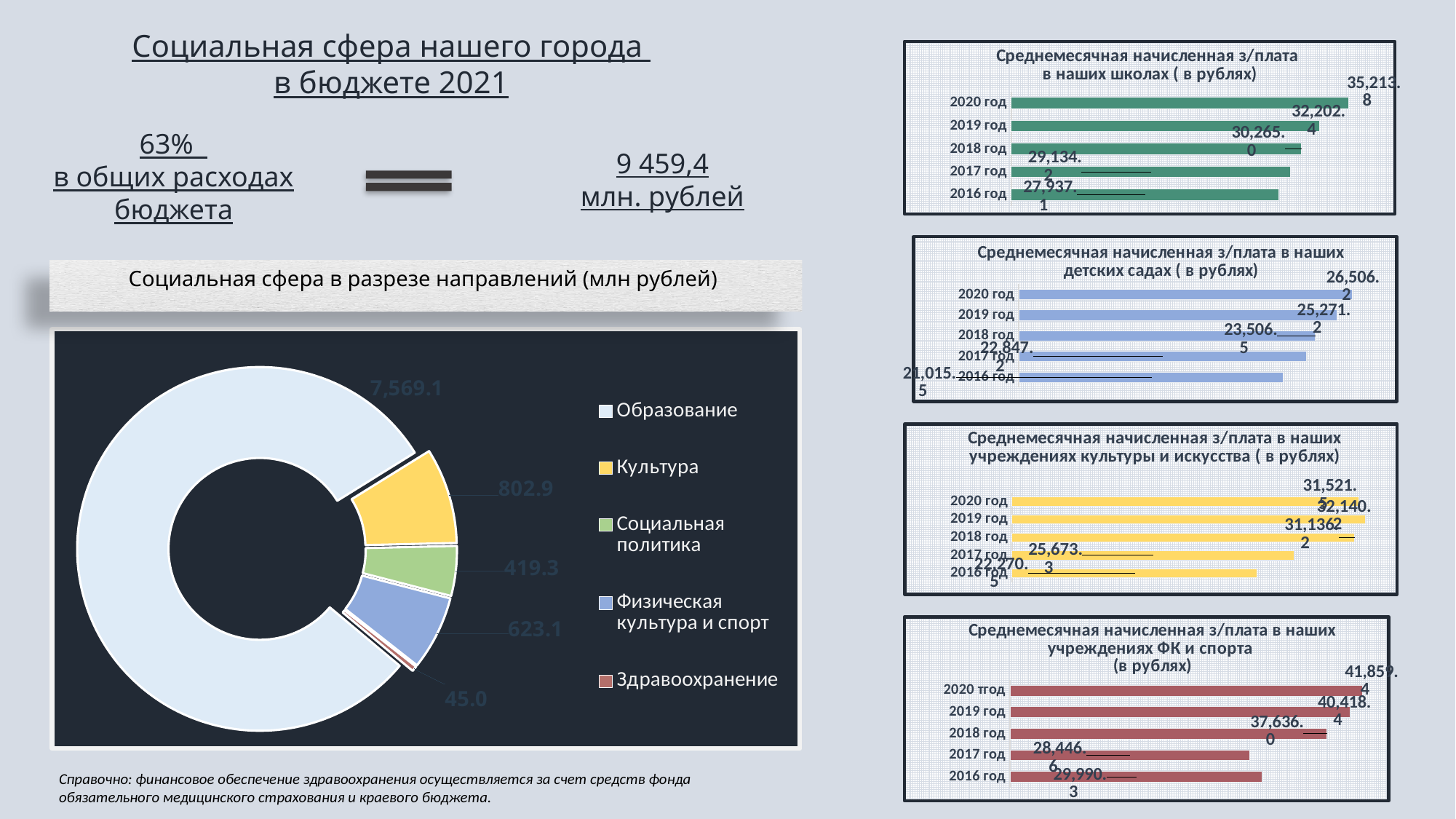
In the doughnut chart 'Социальная сфера в разрезе направлений (млн рублей)', which is larger: Культура or Физическая культура и спорт? Культура In the chart 'Среднемесячная начисленная з/плата в наших учреждениях ФК и спорта (в рублях)', which is larger: 2016 год or 2017 год? 2016 год In the chart 'Среднемесячная начисленная з/плата в наших школах ( в рублях)', what is the value for 2020 год? 35,213.8 In the chart 'Среднемесячная начисленная з/плата в наших школах ( в рублях)', which year has the lowest value? 2016 год In the chart 'Среднемесячная начисленная з/плата в наших детских садах ( в рублях)', what is the value for 2018 год? 23,506.5 In the doughnut chart 'Социальная сфера в разрезе направлений (млн рублей)', which category has the smallest value? Здравоохранение In the chart 'Среднемесячная начисленная з/плата в наших детских садах ( в рублях)', do the values rise or fall from 2016 год to 2020 год? rise In the chart 'Среднемесячная начисленная з/плата в наших учреждениях ФК и спорта (в рублях)', which year has the highest value? 2020 год In the doughnut chart 'Социальная сфера в разрезе направлений (млн рублей)', what is the difference between Культура and Социальная политика? 383.6 What type of chart is 'Среднемесячная начисленная з/плата в наших школах ( в рублях)'? bar chart In the doughnut chart 'Социальная сфера в разрезе направлений (млн рублей)', what is the value for Образование? 7,569.1 In the doughnut chart 'Социальная сфера в разрезе направлений (млн рублей)', how many categories does the legend list? 5